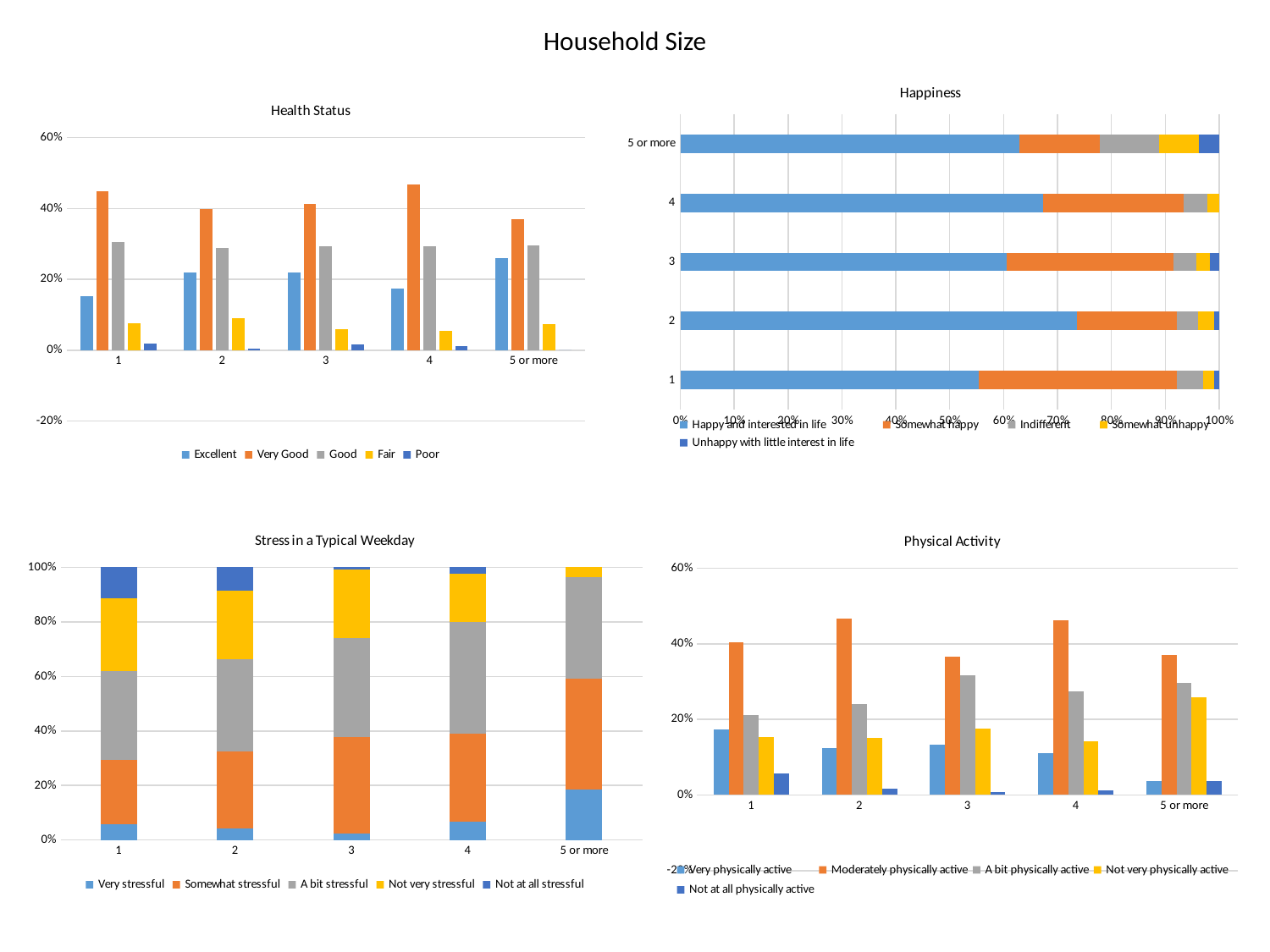
What is the title of the slide? Household Size In the Health Status chart, which is larger: the Excellent value for household size 1 or for household size 5 or more? 5 or more What kind of chart is the Happiness chart? bar chart In the Physical Activity chart, is the 'Not very physically active' value for household size 5 or more greater or less than 20%? greater In the Happiness chart, which household size has the largest 'Happy and interested in life' share? 2 In the Health Status chart, which series has the highest value for household size 3? Very Good In the Stress in a Typical Weekday chart, which is larger: the 'Not at all stressful' share for household size 1 or for household size 3? 1 In the Health Status chart, is the Very Good value for household size 1 greater or less than 40%? greater In the Stress in a Typical Weekday chart, which household size has the largest 'Very stressful' share? 5 or more In the Happiness chart, is the 'Happy and interested in life' share for household size 1 greater or less than 60%? less How many household size categories are shown on the x axis of the Physical Activity chart? 5 How many series does the legend of the Health Status chart list? 5